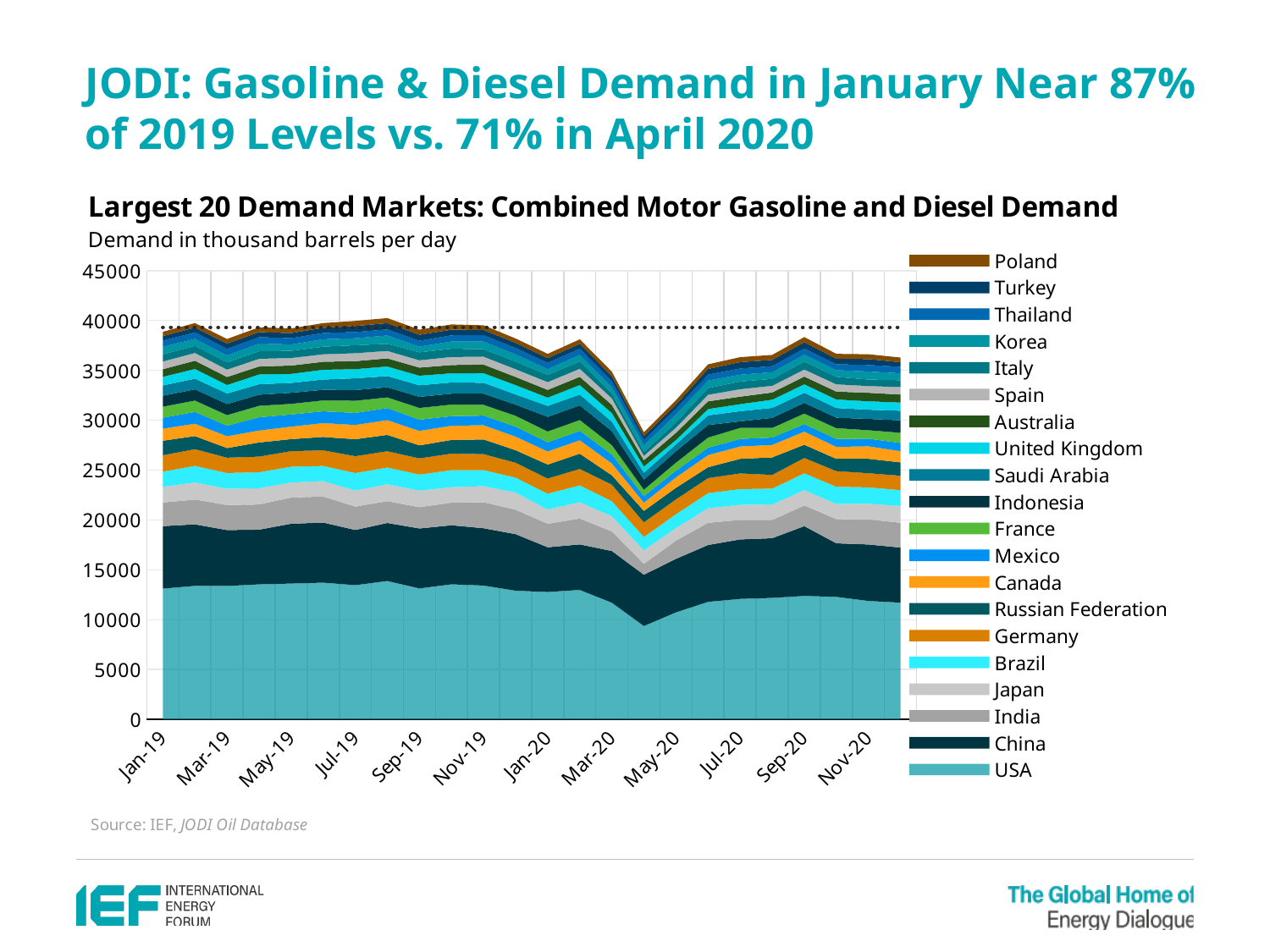
What kind of chart is shown on the slide? Stacked area chart In what unit is demand measured on the chart? Thousand barrels per day Does total demand rise or fall between Jan-20 and the dip between Mar-20 and May-20? fall Does total demand rise or fall between May-20 and Sep-20? rise Is the USA demand in Jan-19 greater or less than 10000 thousand barrels per day? greater How many series does the legend list? 20 Is the total demand at the lowest point of the chart (between Mar-20 and May-20) greater or less than 30000? less How many month labels are shown on the x axis? 12 Is the total demand in Jan-20 greater or less than 35000? greater Which country accounts for the largest share of combined gasoline and diesel demand in the chart? USA Which country has the second-largest band in the stacked area chart? China